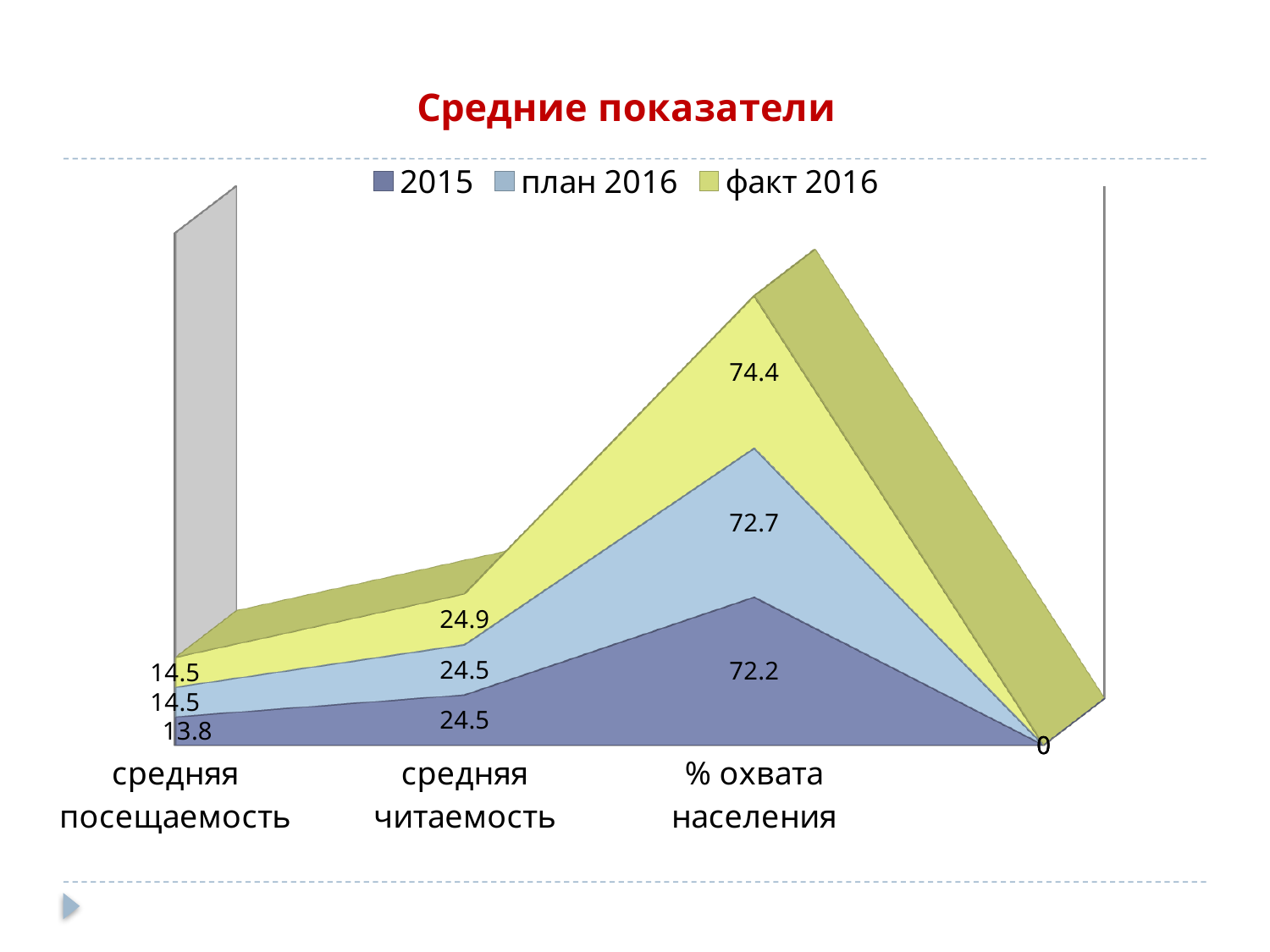
What is the difference between факт 2016 and план 2016 for средняя читаемость? 0.4 Which category has the lowest value for the факт 2016 series? средняя посещаемость What is the title of the chart? Средние показатели What is the value of план 2016 for % охвата населения? 72.7 What is the value of план 2016 for средняя читаемость? 24.5 What is the value of факт 2016 for % охвата населения? 74.4 How many series does the legend list? 3 What is the difference between факт 2016 and 2015 for % охвата населения? 2.2 What kind of chart is shown on the slide? area chart Which category has the highest value for the 2015 series? % охвата населения What is the value of 2015 for средняя посещаемость? 13.8 Which series is listed first in the legend? 2015